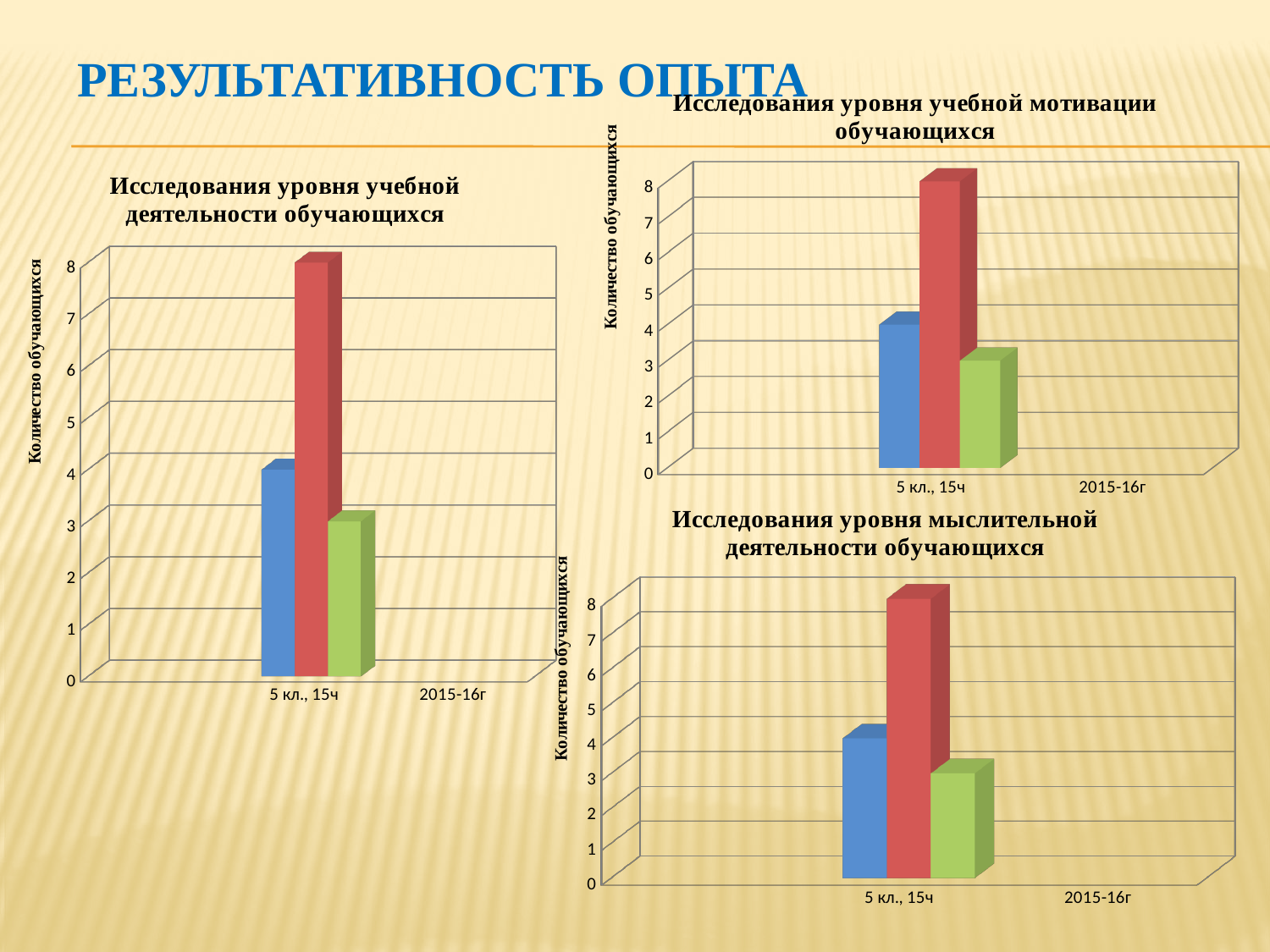
In the chart titled "Исследования уровня учебной деятельности обучающихся", which coloured bar is the shortest? the green bar What kind of chart is the chart titled "Исследования уровня учебной деятельности обучающихся"? bar chart In the chart titled "Исследования уровня учебной мотивации обучающихся", which is taller, the blue bar or the green bar? the blue bar In the chart titled "Исследования уровня мыслительной деятельности обучающихся", which coloured bar is the tallest? the red bar In the chart titled "Исследования уровня учебной деятельности обучающихся", is the value of the blue bar greater or less than 2? greater How many category labels are shown on the horizontal axis of the chart titled "Исследования уровня учебной деятельности обучающихся"? 2 What is the vertical axis label of the chart titled "Исследования уровня учебной мотивации обучающихся"? Количество обучающихся What is the title of the chart at the bottom right of the slide? Исследования уровня мыслительной деятельности обучающихся In the chart titled "Исследования уровня учебной деятельности обучающихся", how many bars are plotted for the category "5 кл., 15ч"? 3 In the chart titled "Исследования уровня мыслительной деятельности обучающихся", is the value of the green bar greater or less than 5? less In the chart titled "Исследования уровня учебной деятельности обучающихся", which coloured bar is the tallest? the red bar In the chart titled "Исследования уровня учебной мотивации обучающихся", is the value of the red bar greater or less than 6? greater